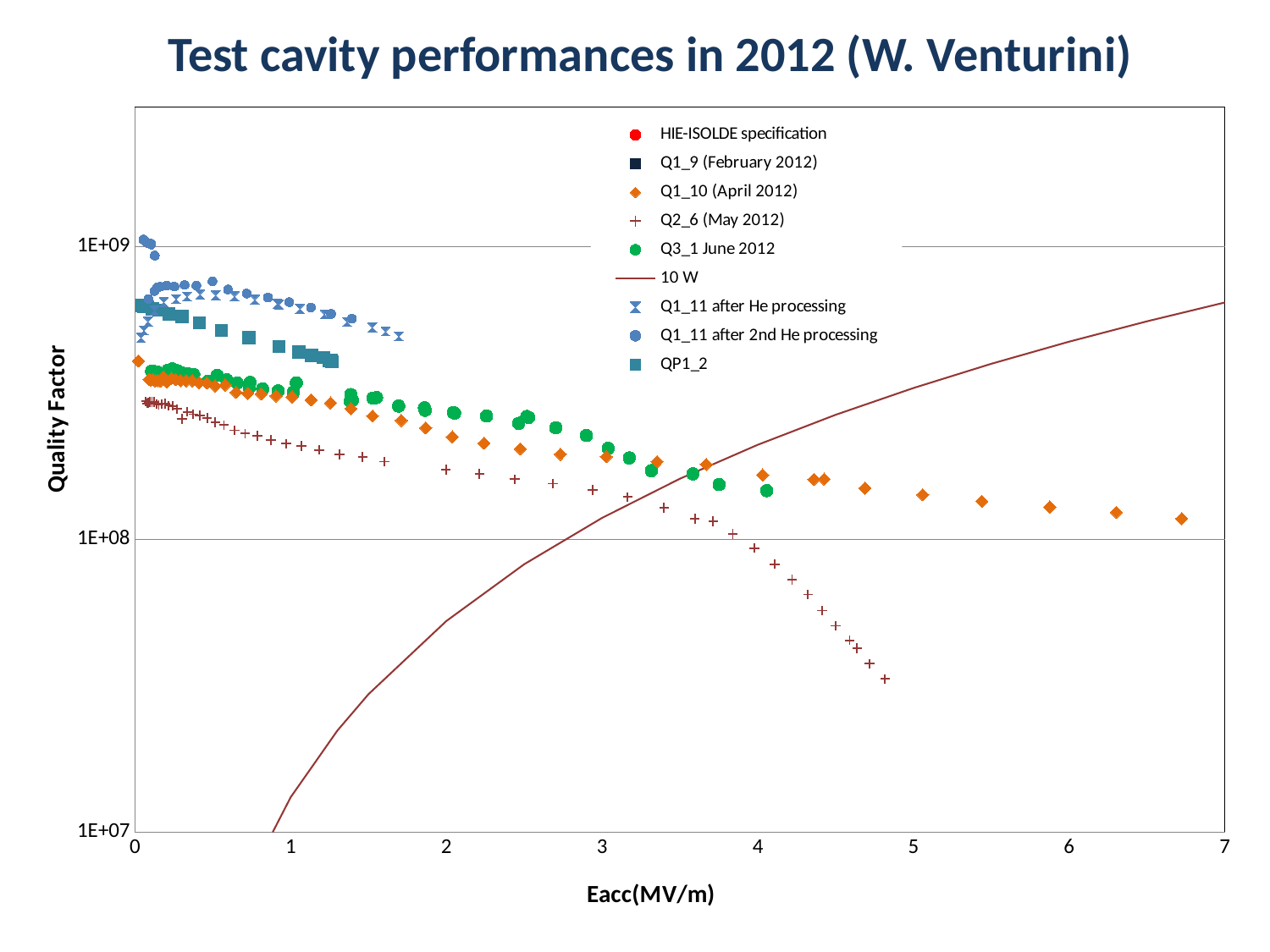
Does the quality factor of the Q1_10 (April 2012) series rise or fall as Eacc increases? fall Which series reaches the lowest quality factor on the chart? 10 W Is the 10 W line at Eacc = 7 MV/m greater or less than 1E+09? less Is the 10 W line at Eacc = 1 MV/m greater or less than 1E+08? less How many series does the legend list? 9 Is the quality factor of the Q2_6 (May 2012) series at its highest Eacc (around 4.8 MV/m) greater or less than 1E+08? less What is the title of the chart? Test cavity performances in 2012 (W. Venturini) Does the 10 W line rise or fall as Eacc increases? rise What kind of chart is shown on the slide? scatter chart What is the label of the y axis? Quality Factor Which series extends to the highest Eacc value? Q1_10 (April 2012)